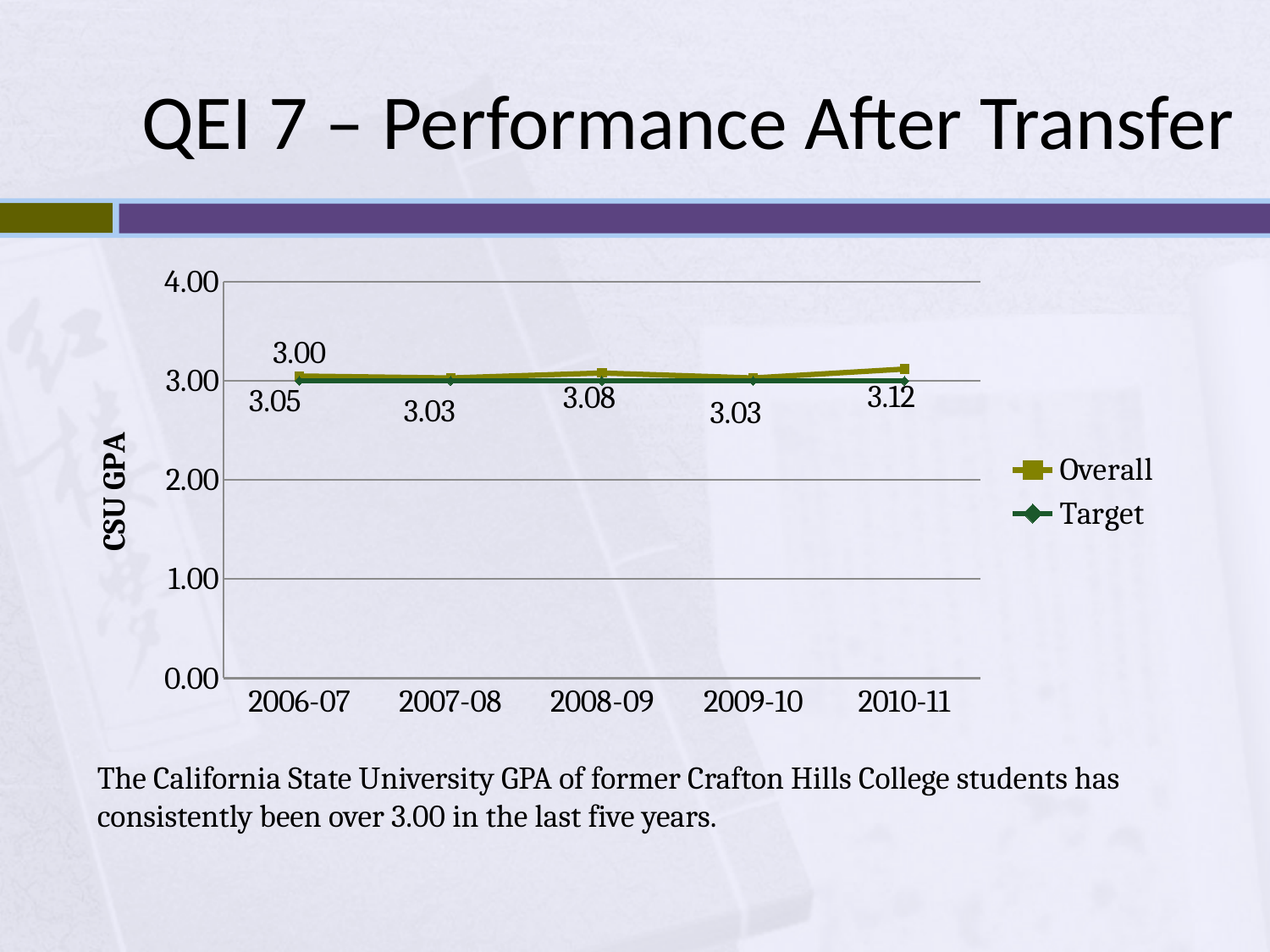
Which is larger, the Overall CSU GPA in 2008-09 or in 2007-08? 2008-09 What kind of chart is shown on the slide? line chart What is the Overall CSU GPA for 2008-09? 3.08 What is the Target value shown for 2006-07? 3.00 How many series does the legend list? 2 What is the Overall CSU GPA for 2006-07? 3.05 How many academic years are shown on the x axis? 5 What is the difference between the Overall CSU GPA in 2010-11 and in 2006-07? 0.07 What is the Overall CSU GPA for 2010-11? 3.12 What is the difference between the Overall CSU GPA in 2008-09 and in 2009-10? 0.05 In which year is the Overall CSU GPA highest? 2010-11 Is the Overall CSU GPA for 2010-11 greater or less than 2.00? greater